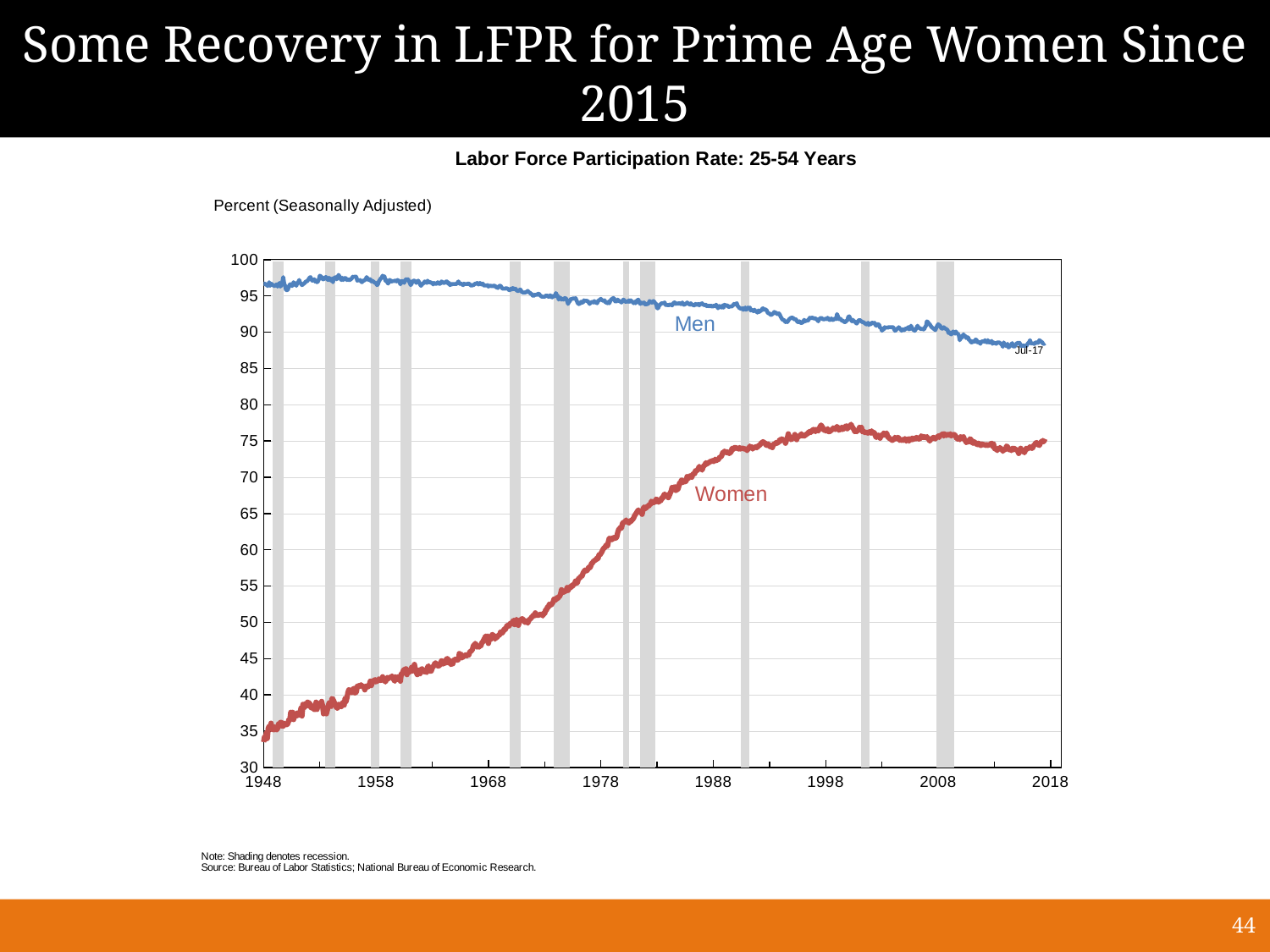
Is the value for Women in 1948 greater or less than 40? less What kind of chart is shown on the slide? line chart Is the value for Women in 2018 greater or less than 70? greater Is the value for Women in 1968 greater or less than 50? less According to the note, what does the shading on the chart denote? recession Which series has the higher value in 2018, Men or Women? Men How many series are plotted on the chart? 2 What is the title of the chart? Labor Force Participation Rate: 25-54 Years Does the Women series rise or fall from 1948 to 1998? rise Does the Men series rise or fall from 1948 to 2018? fall